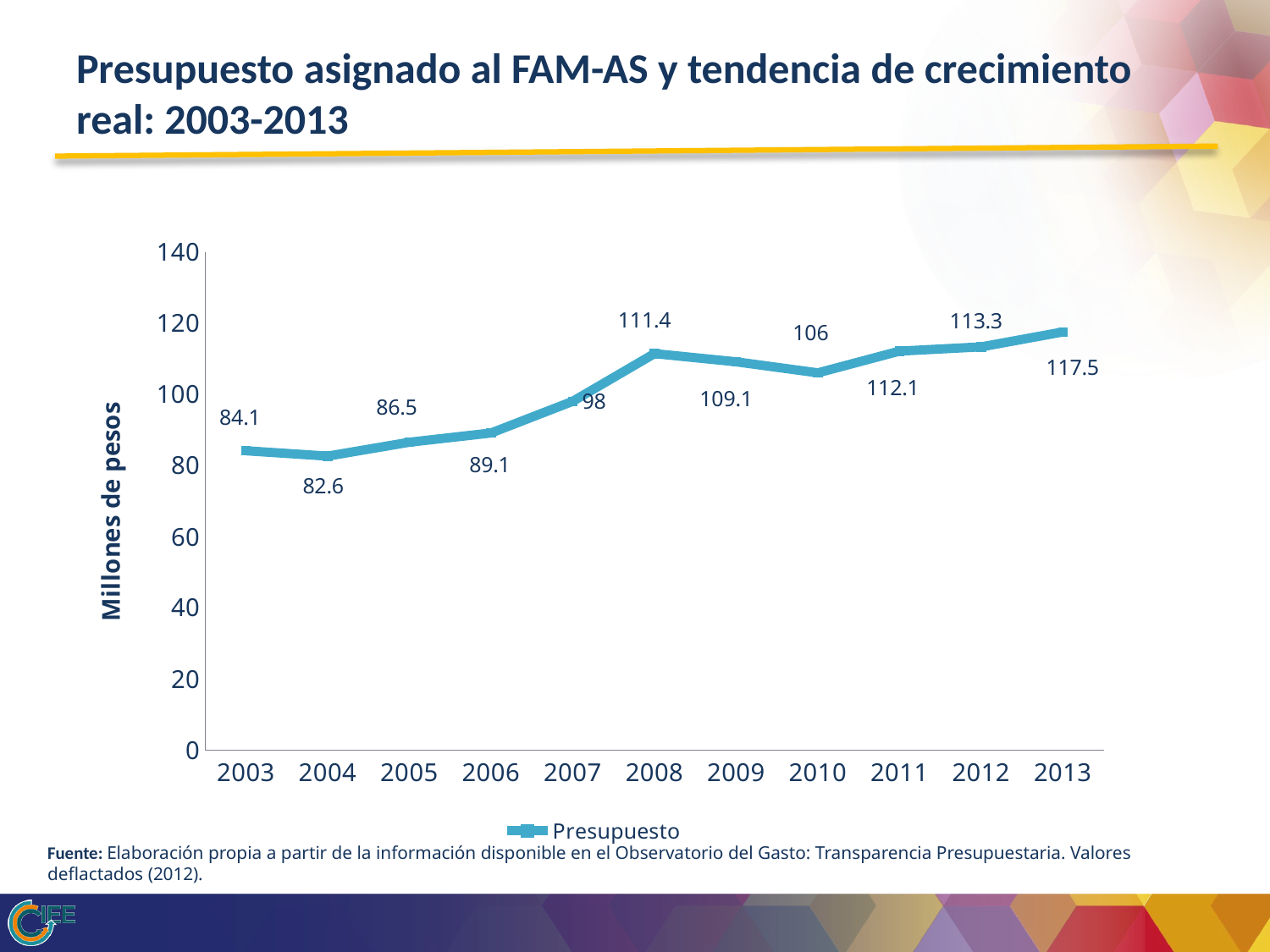
What kind of chart is shown? line chart What is the value for 2008? 111.4 How many years are plotted on the x axis? 11 Which year has the lowest value? 2004 What is the value for 2013? 117.5 How many series does the legend list? 1 What is the label on the y axis? Millones de pesos What is the value for 2003? 84.1 Which year has the highest value? 2013 What is the difference between the values for 2013 and 2003? 33.4 Is the value for 2010 greater or less than 100? greater Which is larger, the value for 2008 or the value for 2009? 2008